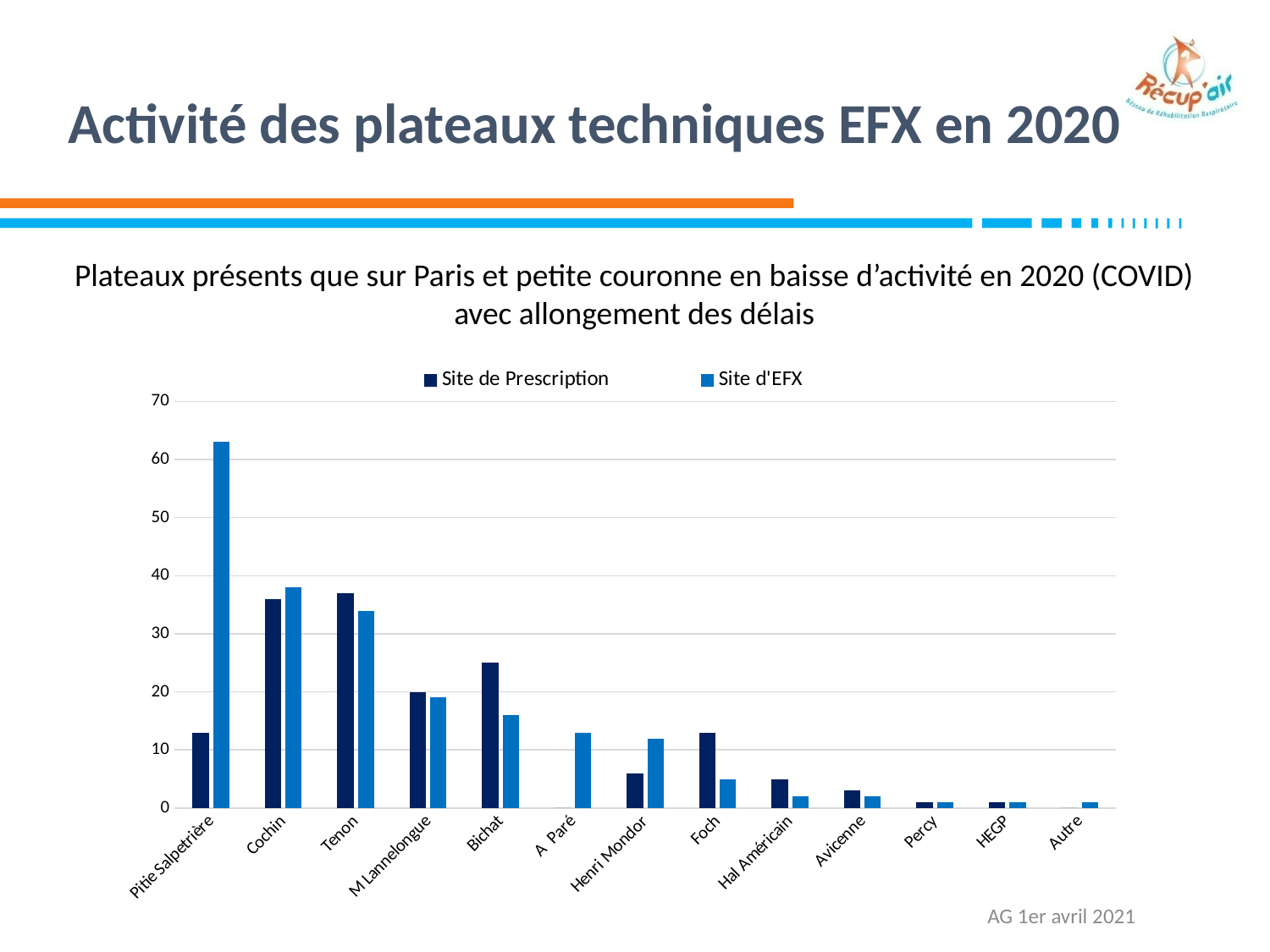
How many series does the legend list? 2 For Bichat, which series has the larger value, Site de Prescription or Site d'EFX? Site de Prescription What kind of chart is shown on the slide? bar chart Is the Site d'EFX value for Pitié Salpêtrière greater or less than 60? greater Is the Site de Prescription value for Cochin greater or less than 30? greater What are the two series named in the legend? Site de Prescription and Site d'EFX For Henri Mondor, which series has the larger value, Site de Prescription or Site d'EFX? Site d'EFX How many categories are shown on the x axis? 13 For Pitié Salpêtrière, which series has the larger value, Site de Prescription or Site d'EFX? Site d'EFX Is the Site de Prescription value for Bichat greater or less than 20? greater Which category has the highest value for Site d'EFX? Pitie Salpetrière